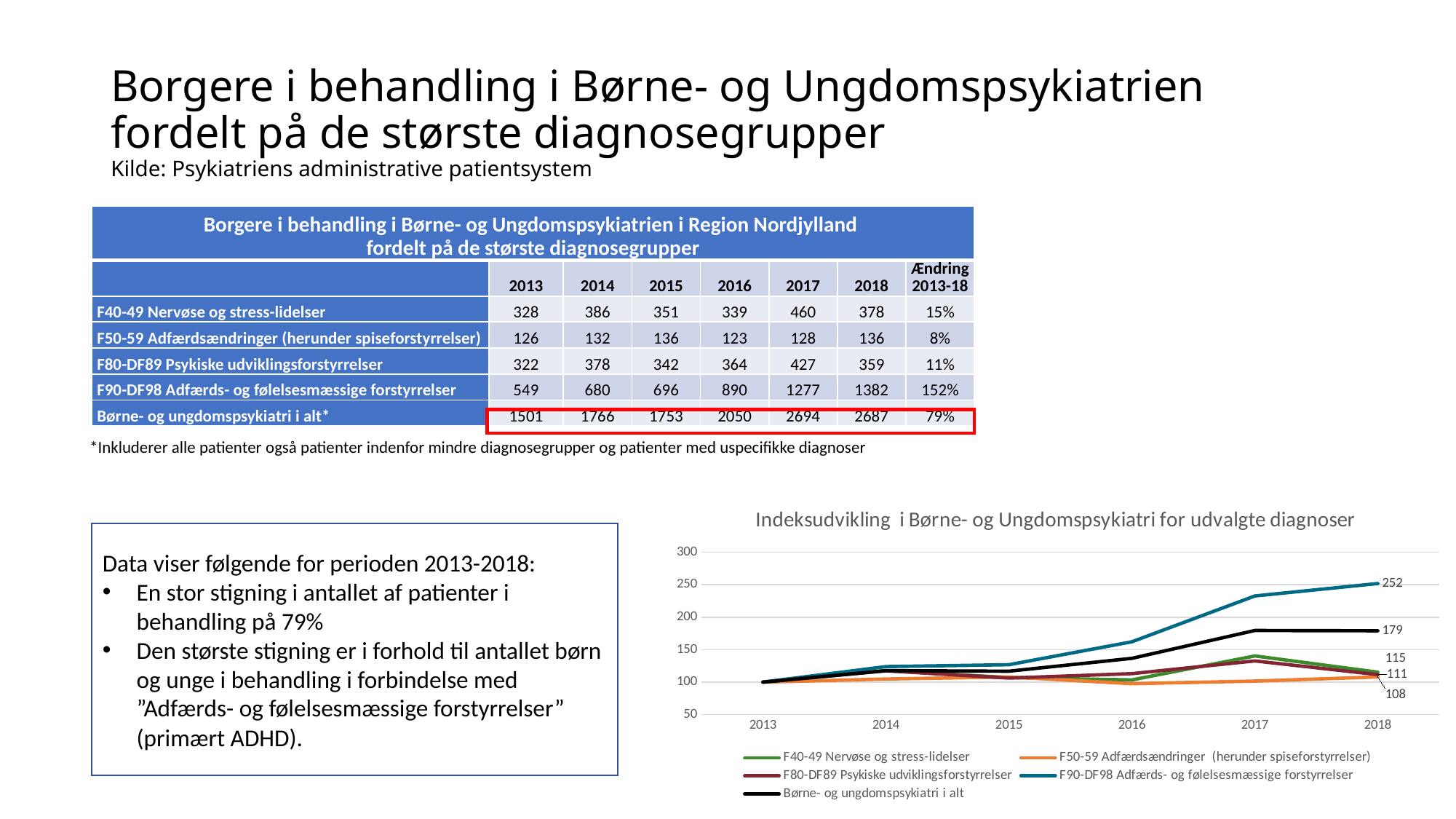
Is the 2016 index value for Børne- og ungdomspsykiatri i alt greater or less than 150? less In the line chart, what is the 2018 index value for F90-DF98 Adfærds- og følelsesmæssige forstyrrelser? 252 How many series does the legend of the line chart list? 5 What kind of chart is shown on the slide? line chart How many years are shown on the x axis of the line chart? 6 In 2018, which is larger in the line chart: F90-DF98 Adfærds- og følelsesmæssige forstyrrelser or Børne- og ungdomspsykiatri i alt? F90-DF98 Adfærds- og følelsesmæssige forstyrrelser In the line chart, what is the 2018 index value for Børne- og ungdomspsykiatri i alt? 179 What is the difference between the 2018 index values of F90-DF98 Adfærds- og følelsesmæssige forstyrrelser and Børne- og ungdomspsykiatri i alt? 73 Does the index for F90-DF98 Adfærds- og følelsesmæssige forstyrrelser rise or fall from 2013 to 2018? rise Which series has the highest index value in 2018 in the line chart? F90-DF98 Adfærds- og følelsesmæssige forstyrrelser Is the 2017 index value for F90-DF98 Adfærds- og følelsesmæssige forstyrrelser greater or less than 200? greater What is the title of the line chart? Indeksudvikling i Børne- og Ungdomspsykiatri for udvalgte diagnoser